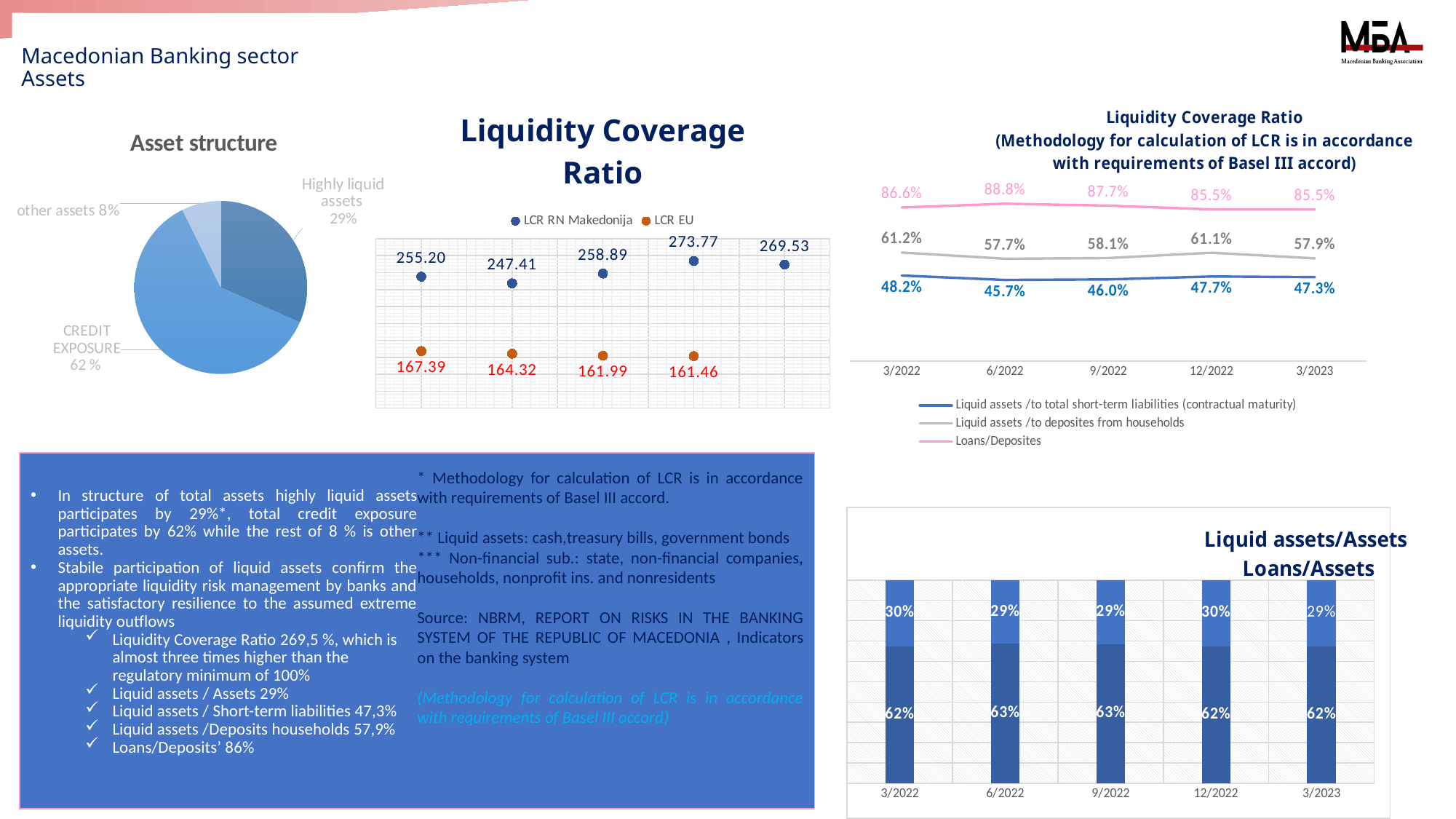
In the Liquidity Coverage Ratio line chart on the right, what is the value of Loans/Deposites at 6/2022? 88.8% In the Asset structure pie chart, what share is Highly liquid assets? 29% In the Liquidity Coverage Ratio scatter chart in the middle of the slide, what is the highest value for LCR RN Makedonija? 273.77 What kind of chart is the Liquid assets/Assets Loans/Assets chart at the bottom right? stacked bar chart In the Liquidity Coverage Ratio scatter chart in the middle of the slide, what is the lowest value for LCR EU? 161.46 In the Liquidity Coverage Ratio line chart on the right, what is the value of Liquid assets /to total short-term liabilities at 3/2023? 47.3% In the Liquidity Coverage Ratio scatter chart in the middle of the slide, how many LCR EU points are plotted? 4 In the Asset structure pie chart, what share is CREDIT EXPOSURE? 62 % In the Liquid assets/Assets Loans/Assets bar chart, what is the total of the stacked bar for 3/2022? 92% In the Liquidity Coverage Ratio line chart on the right, what is the difference between Liquid assets /to deposites from households at 3/2022 and at 6/2022? 3.5% In the Liquidity Coverage Ratio scatter chart in the middle of the slide, how many series does the legend list? 2 In the Asset structure pie chart, which slice is the smallest? other assets